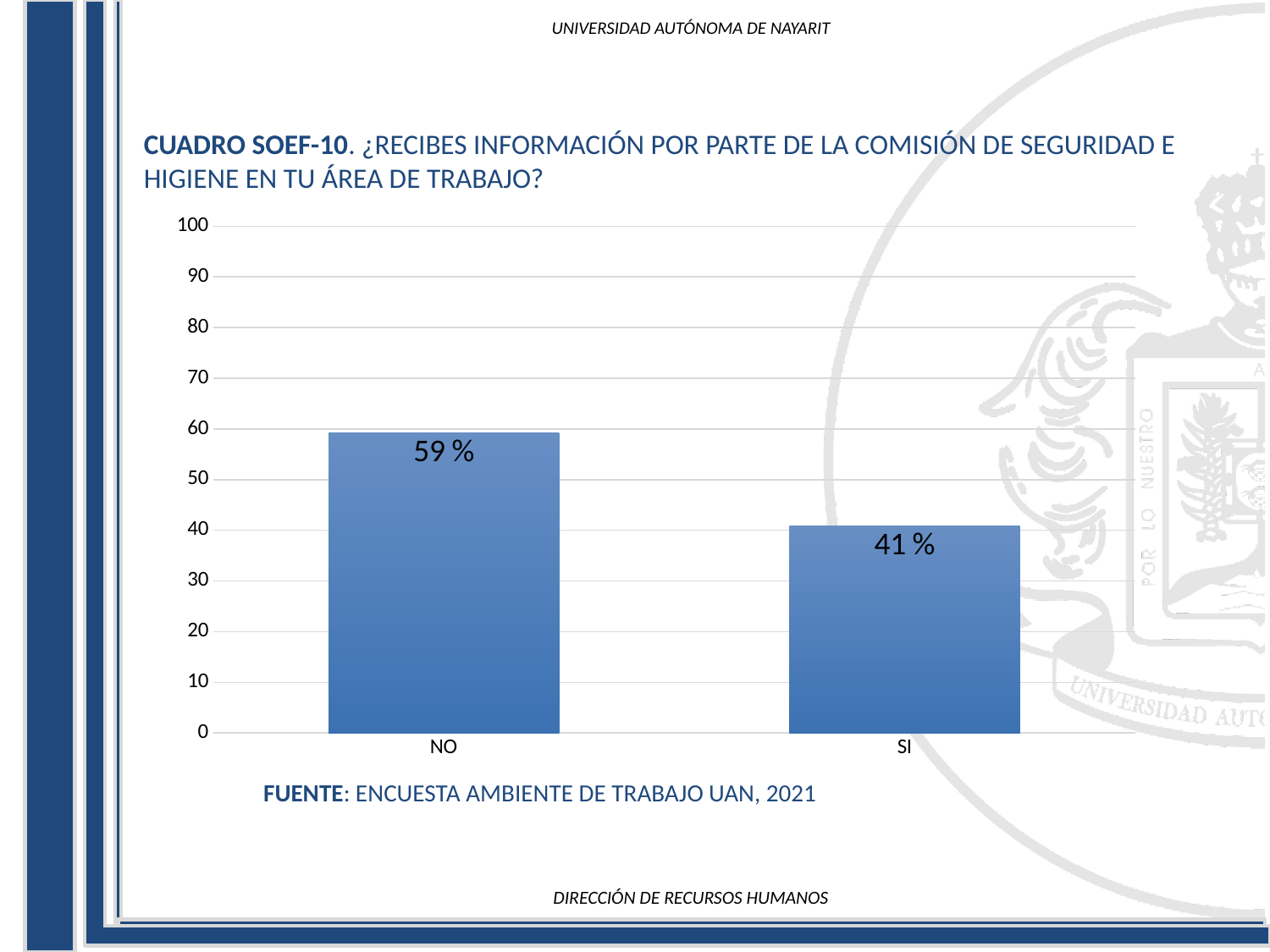
What is the maximum value shown on the vertical axis? 100 Is the value for NO greater or less than 50? greater Which category has the lowest value? SI Is the value for SI greater or less than 50? less What is the difference between the values for NO and SI? 18 % What is the value for SI? 41 % How many categories are shown on the x axis? 2 Which is larger, the value for NO or the value for SI? NO What is the value for NO? 59 % What source is cited below the chart? ENCUESTA AMBIENTE DE TRABAJO UAN, 2021 What kind of chart is shown on the slide? bar chart Which category has the highest value? NO